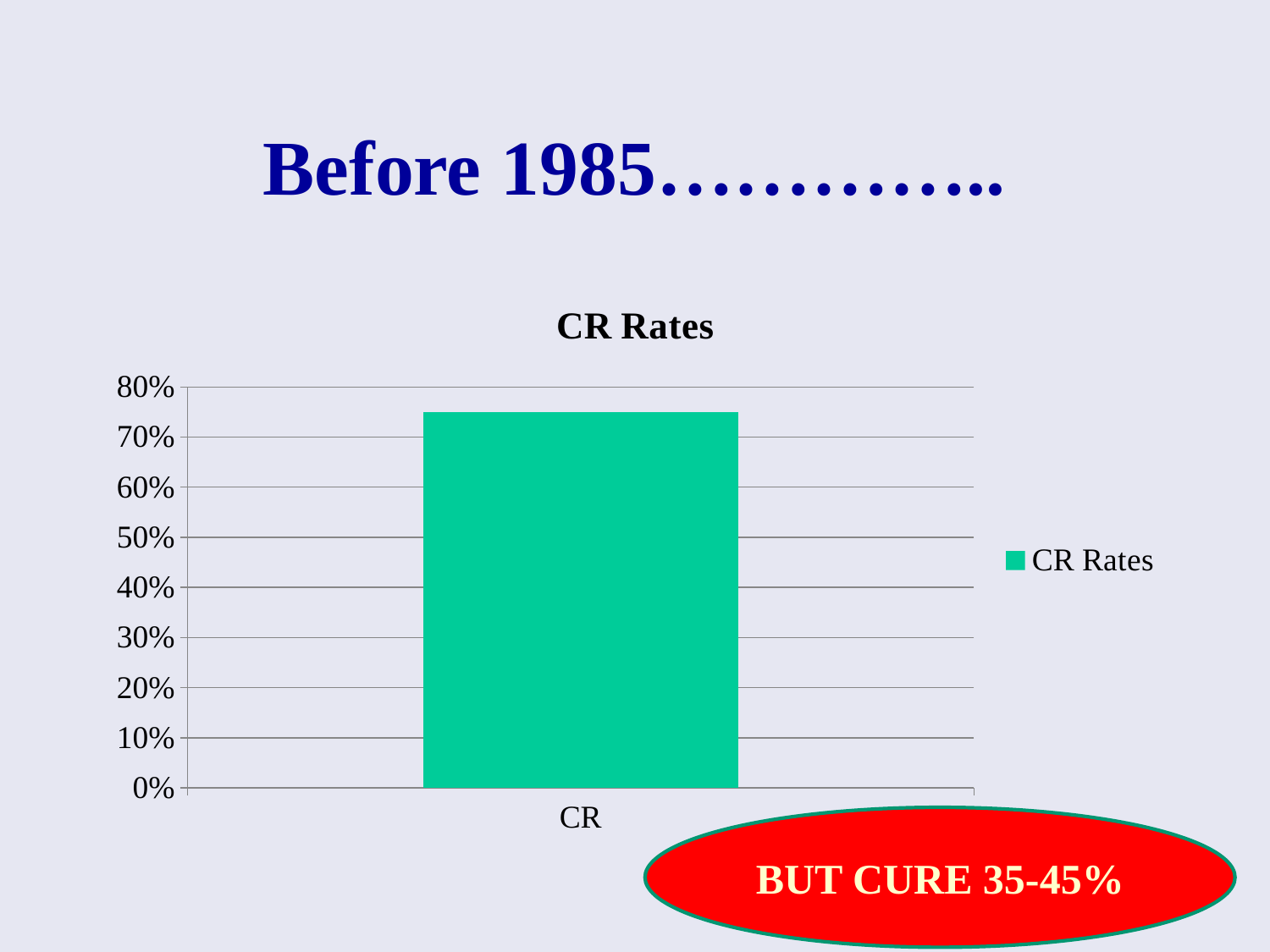
What is the highest value shown on the y axis? 80% What is the label of the single category on the x axis? CR Is the value for CR greater or less than 80%? less How many categories are plotted on the x axis? 1 What kind of chart is shown on the slide? bar chart How many series does the legend list? 1 What is the title of the chart? CR Rates Is the value for CR greater or less than 70%? greater Is the value for CR greater or less than 50%? greater